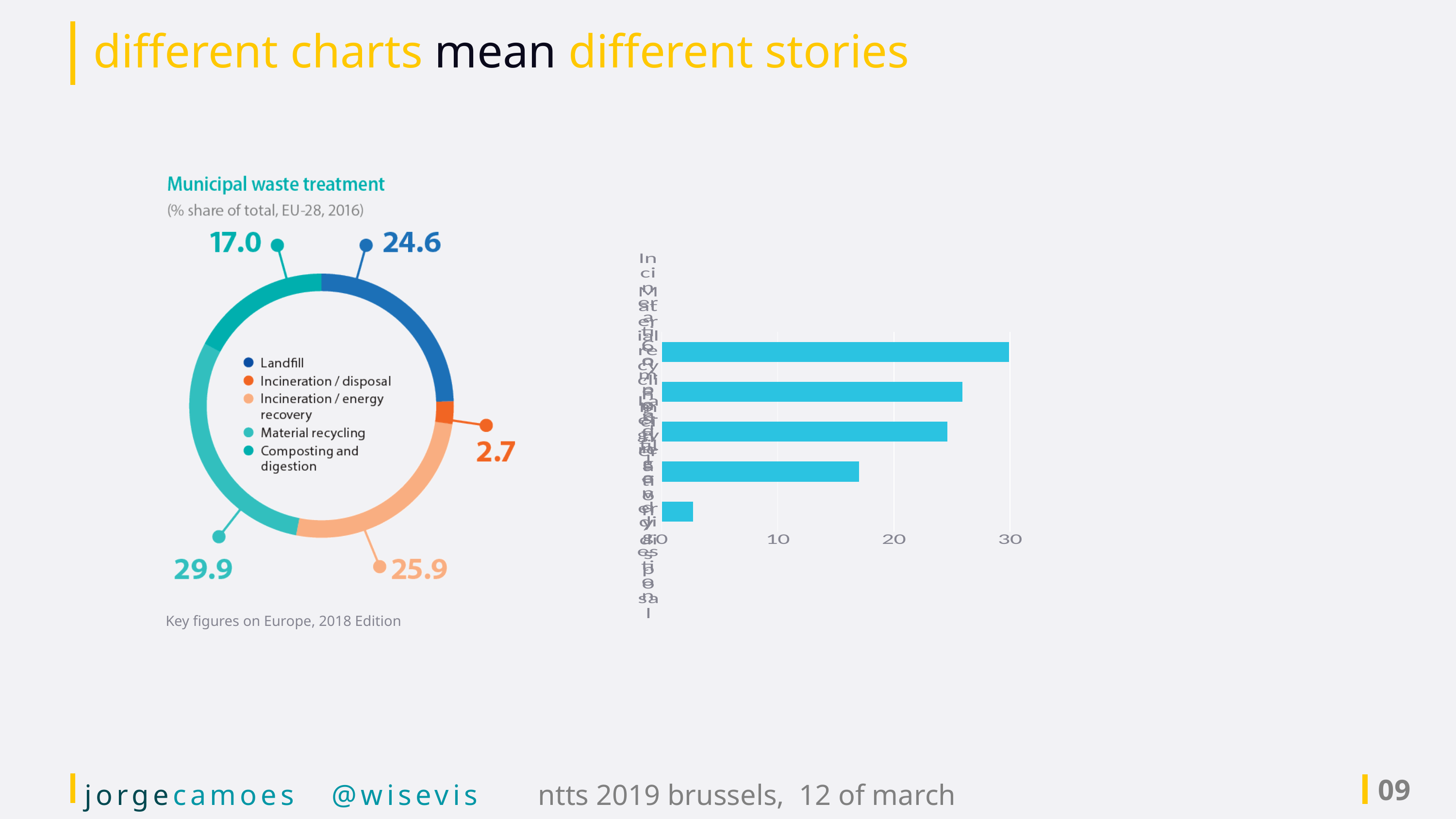
In the Municipal waste treatment chart, what is the difference between Material recycling and Landfill? 5.3 What kind of chart is the chart on the right of the slide? Bar chart In the Municipal waste treatment chart, what is the share for Incineration / disposal? 2.7 In the Municipal waste treatment chart, which category has the largest share? Material recycling In the Municipal waste treatment chart, what is the share for Material recycling? 29.9 In the Municipal waste treatment chart, which category has the smallest share? Incineration / disposal In the Municipal waste treatment chart, what is the share for Composting and digestion? 17.0 In the Municipal waste treatment chart, what is the share for Landfill? 24.6 How many bars does the chart on the right of the slide have? 5 In the Municipal waste treatment chart, which is larger: Incineration / energy recovery or Composting and digestion? Incineration / energy recovery In the chart on the right of the slide, is the value of the top bar greater or less than 20? greater How many categories does the legend of the Municipal waste treatment chart list? 5